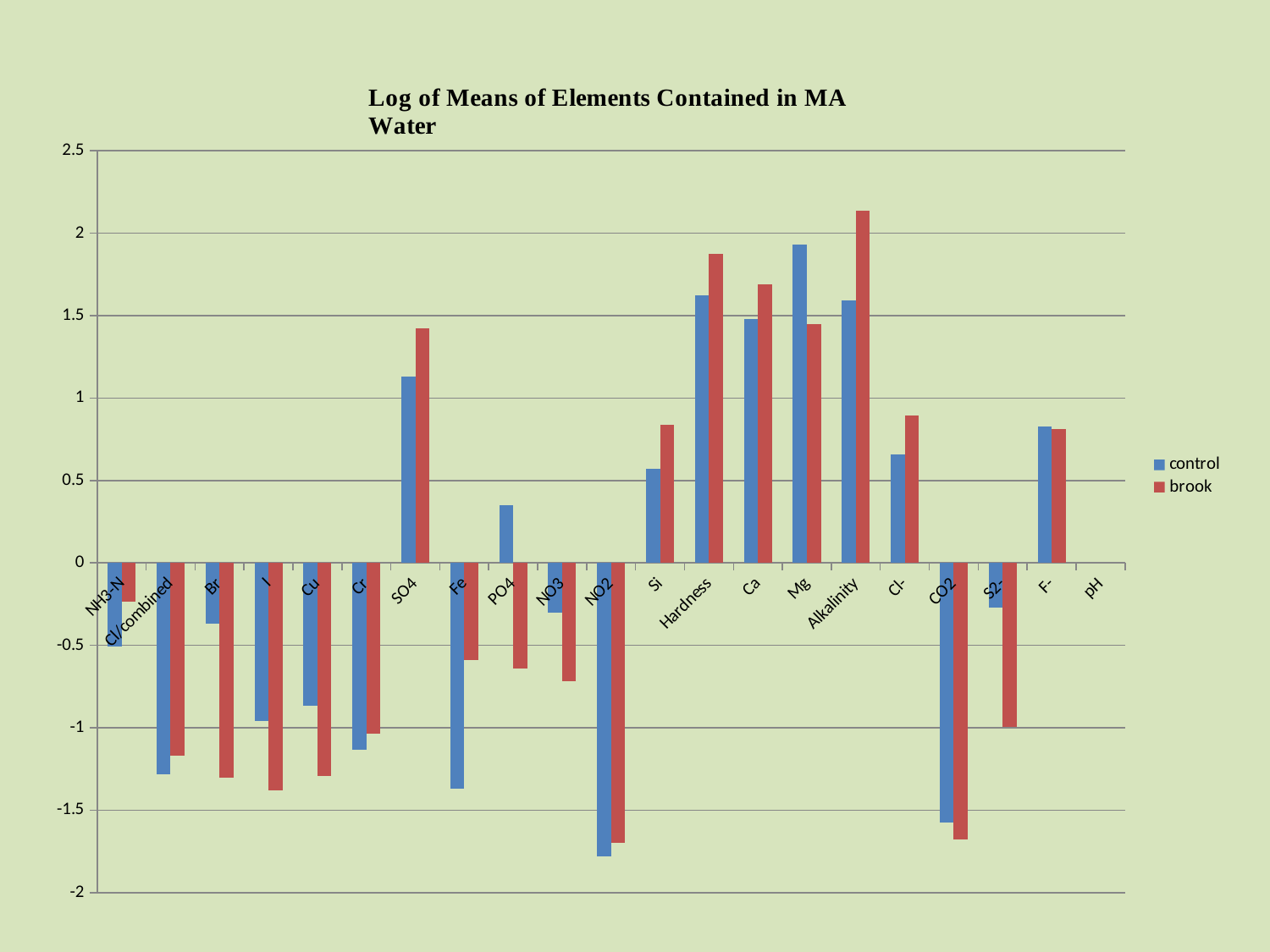
Which category has the lowest value for the control series? NO2 How many categories are shown along the x axis? 21 What is the title of the chart? Log of Means of Elements Contained in MA Water Is the brook value for SO4 greater or less than 1? greater Which category has the highest value for the control series? Mg Is the brook value for Hardness greater or less than 1.5? greater What kind of chart is shown on the slide? bar chart Which category has the highest value for the brook series? Alkalinity For Si, which series has the larger value, control or brook? brook For Mg, which series has the larger value, control or brook? control How many series does the legend list? 2 Is the control value for Fe greater or less than -1? less